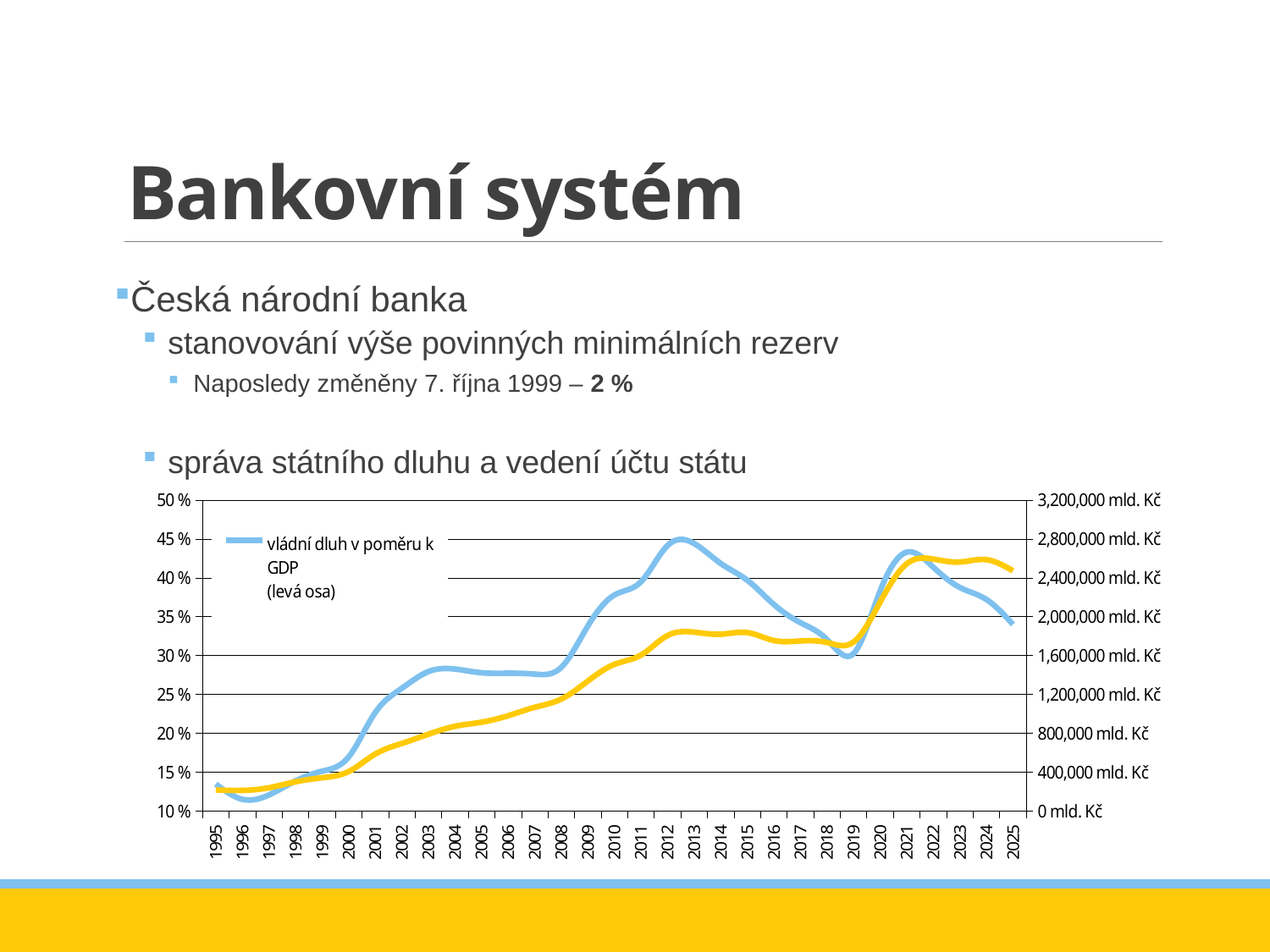
What is the highest value shown on the right-hand axis of the chart? 3,200,000 mld. Kč Is the value of 'vládní dluh v poměru k GDP' in 2003 greater or less than 30 %? less Is the value of 'vládní dluh v poměru k GDP' in 1996 greater or less than 15 %? less What kind of chart is shown on the slide? line chart How many years are shown on the x axis of the chart? 31 In which year is the blue line 'vládní dluh v poměru k GDP' at its lowest value? 1996 Does the blue line 'vládní dluh v poměru k GDP' rise or fall between 2013 and 2019? fall Is the value of 'vládní dluh v poměru k GDP' in 2021 greater or less than 40 %? greater Does the blue line 'vládní dluh v poměru k GDP' rise or fall between 1999 and 2012? rise Which year has the higher value of 'vládní dluh v poměru k GDP': 2008 or 2010? 2010